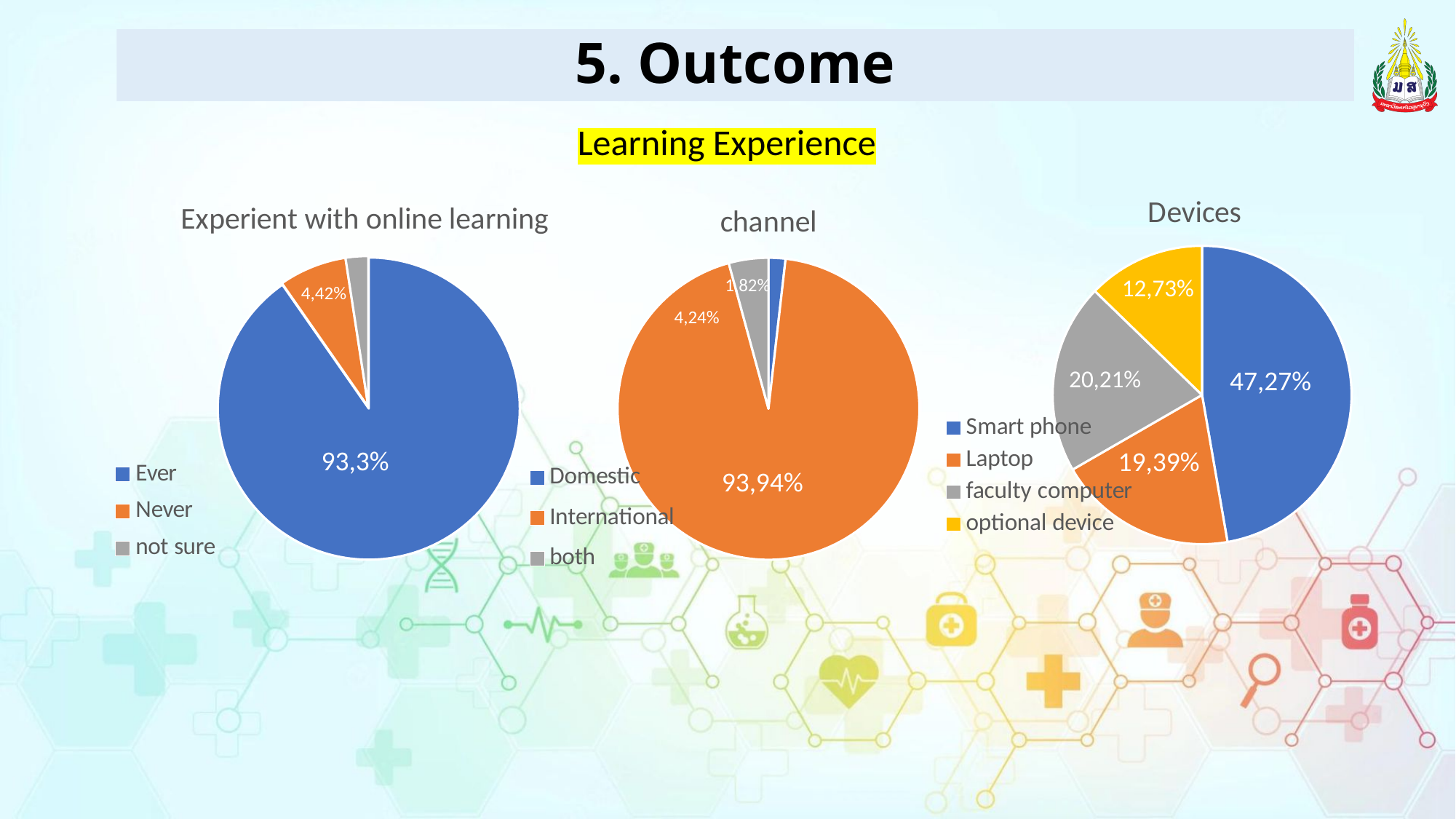
What kind of chart is the 'Experient with online learning' chart? pie chart In the Devices chart, which device has the smallest share? optional device In the Devices chart, which device has the largest share? Smart phone In the channel chart, what share is shown for International? 93,94% In the Devices chart, what share is shown for optional device? 12,73% In the Devices chart, what colour represents Laptop? orange In the channel chart, which category has the smallest slice? Domestic In the Devices chart, what is the difference between the faculty computer share and the Laptop share? 0,82% In the Devices chart, what share is shown for Smart phone? 47,27% In the 'Experient with online learning' chart, what share is shown for Ever? 93,3% In the 'Experient with online learning' chart, what share is shown for Never? 4,42% How many categories does the Devices chart show? 4